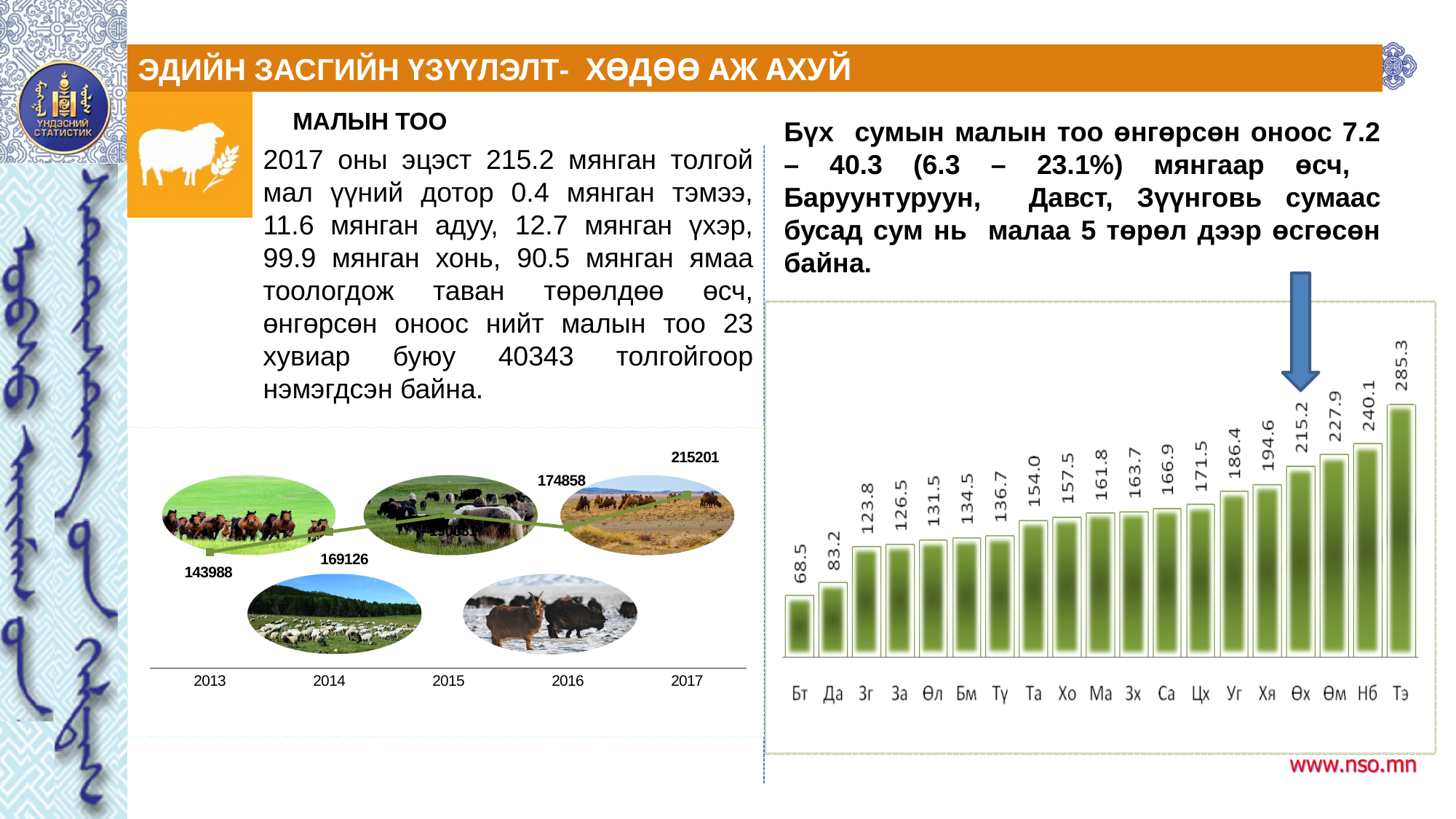
In the bar chart on the right, what is the value for Тэ? 285.3 In the line chart on the left, what is the difference between the values for 2017 and 2016? 40343 In the line chart on the left, what is the value for 2017? 215201 In the bar chart on the right, which category has the highest value? Тэ In the bar chart on the right, which category has the lowest value? Бт In the line chart on the left, what is the value for 2013? 143988 What kind of chart is the chart on the right? bar chart In the bar chart on the right, what is the difference between the values for Тэ and Нб? 45.2 In the bar chart on the right, what is the value for Бт? 68.5 How many categories are shown in the bar chart on the right? 19 In the bar chart on the right, which is larger, the value for Да or the value for Зг? Зг In the bar chart on the right, what is the value for Өх? 215.2